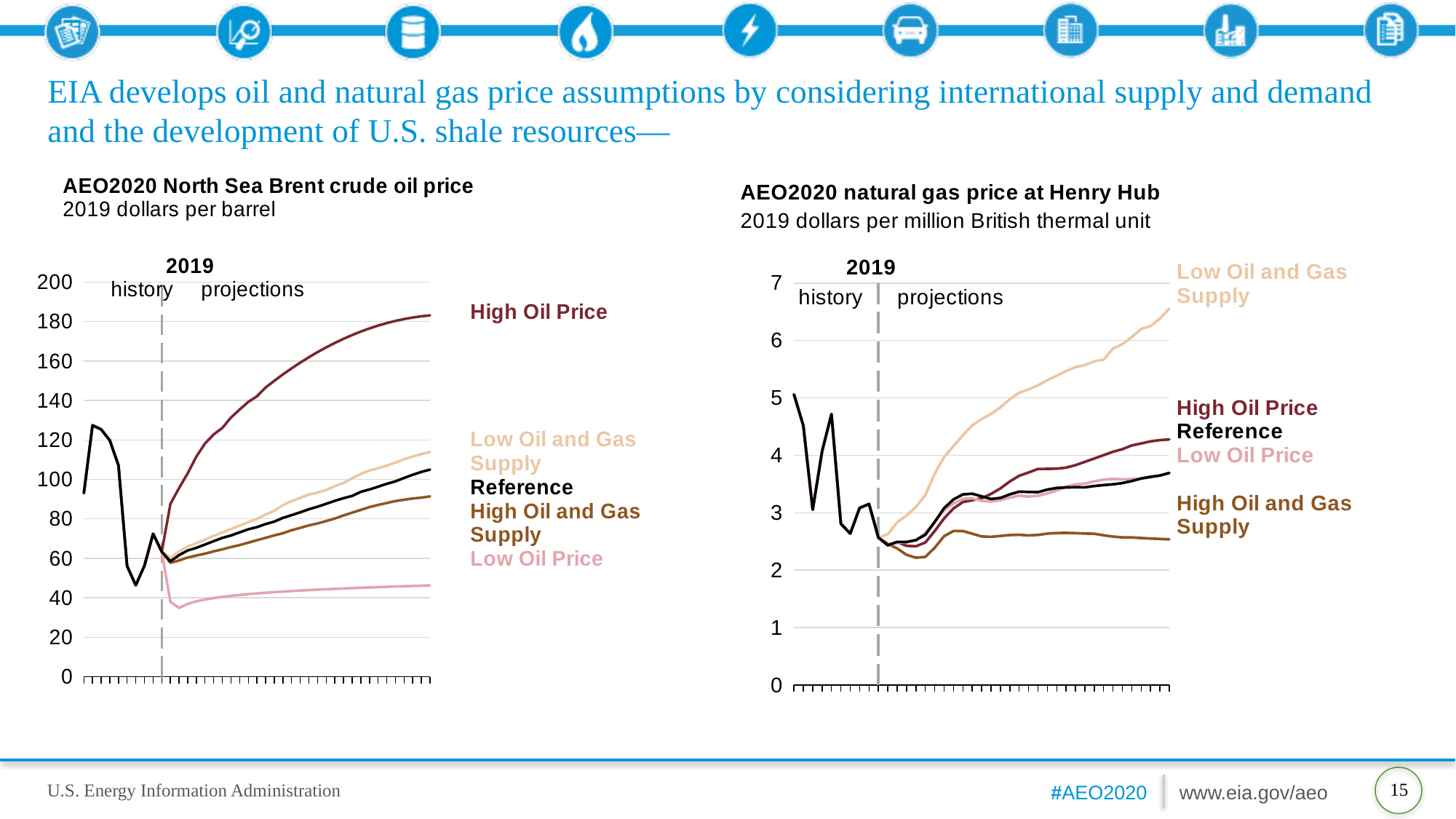
In the AEO2020 North Sea Brent crude oil price chart, is the High Oil Price value at the end of the projections greater or less than 160? greater In the AEO2020 North Sea Brent crude oil price chart, which is higher at the end of the projections: Reference or High Oil and Gas Supply? Reference In the AEO2020 natural gas price at Henry Hub chart, which scenario has the highest price at the end of the projection period? Low Oil and Gas Supply In the AEO2020 natural gas price at Henry Hub chart, which scenario has the lowest price at the end of the projection period? High Oil and Gas Supply How many scenario series are labelled on the AEO2020 natural gas price at Henry Hub chart? 5 In the AEO2020 natural gas price at Henry Hub chart, does the Low Oil and Gas Supply line rise or fall over the projection period? rise In the AEO2020 North Sea Brent crude oil price chart, is the Low Oil Price value at the end of the projections greater or less than 60? less What unit is used on the AEO2020 North Sea Brent crude oil price chart? 2019 dollars per barrel In the AEO2020 natural gas price at Henry Hub chart, is the High Oil and Gas Supply value at the end of the projections greater or less than 3? less What kind of chart is the AEO2020 North Sea Brent crude oil price chart? line chart In the AEO2020 North Sea Brent crude oil price chart, which scenario has the lowest price at the end of the projection period? Low Oil Price In the AEO2020 North Sea Brent crude oil price chart, which scenario has the highest price at the end of the projection period? High Oil Price